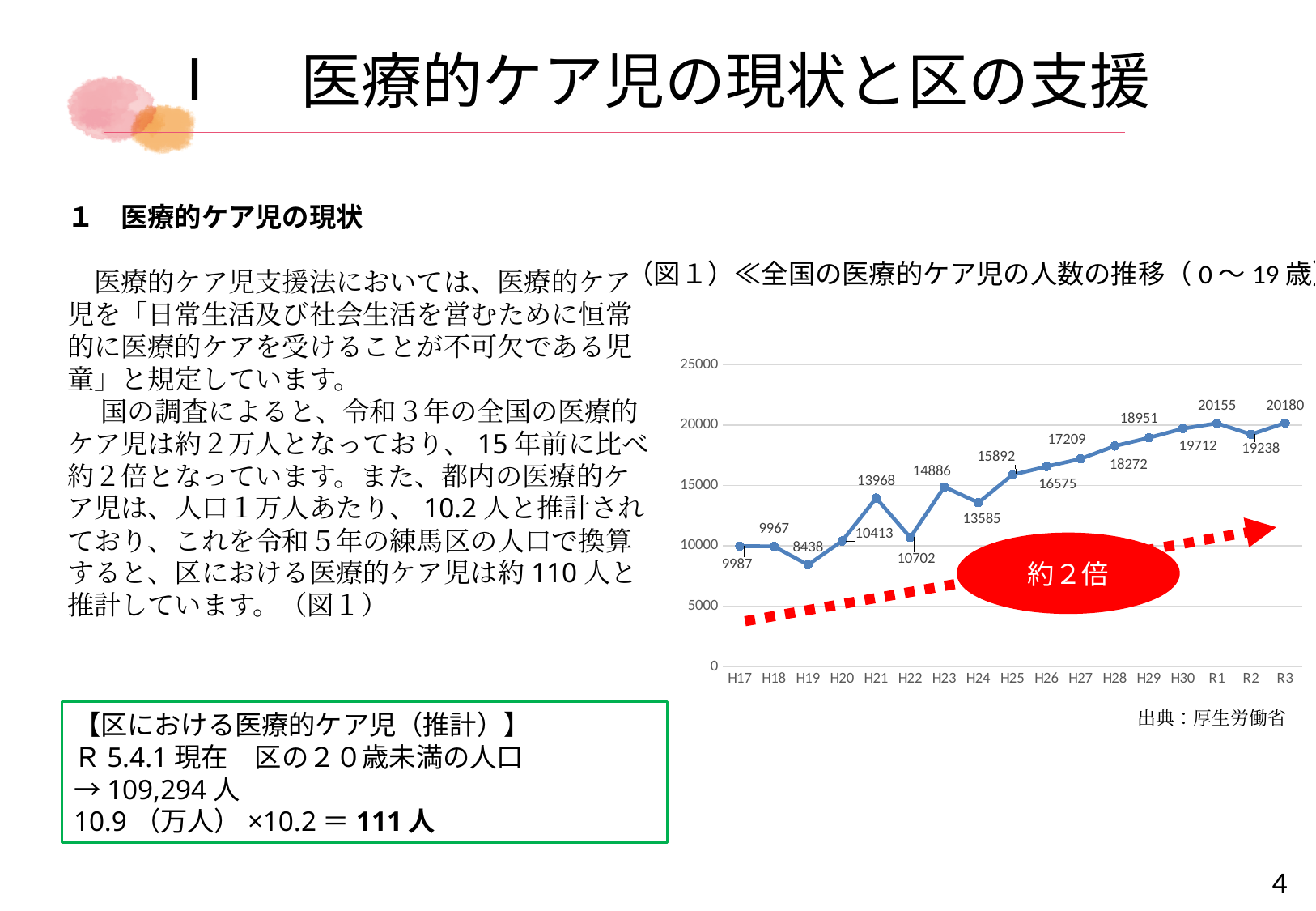
What is the difference between the values for R3 and H17? 10193 What is the source cited below the chart? 厚生労働省 What is the value for R3 in the line chart? 20180 What kind of chart is shown on the slide? line chart Which year has the highest value in the line chart? R3 What is the value for H19 in the line chart? 8438 Do the values generally rise or fall from H17 to R3? rise How many data points are plotted in the line chart? 17 What is the value for H21 in the line chart? 13968 Is the value for H25 greater or less than 15000? greater Which year has the lowest value in the line chart? H19 Which is larger, the value for H22 or the value for H23? H23